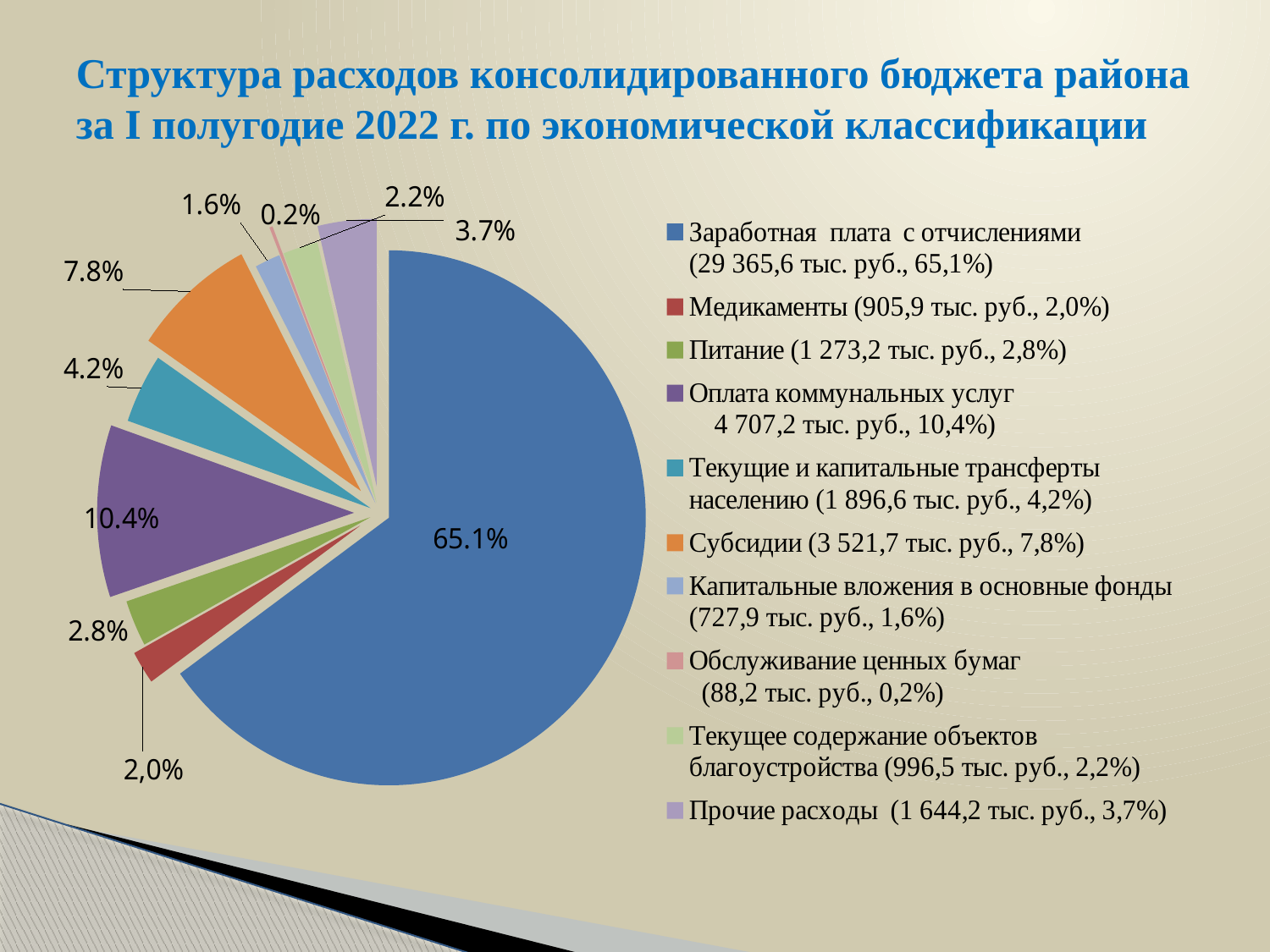
According to the legend, what amount in тыс. руб. is given for Прочие расходы? 1 644,2 тыс. руб. What share of the pie does the slice for Оплата коммунальных услуг represent? 10.4% What share of the pie does the slice for Обслуживание ценных бумаг represent? 0.2% Which category has the largest slice of the pie? Заработная плата с отчислениями How many slices does the pie chart have? 10 What is the difference in percentage points between the share for Оплата коммунальных услуг and the share for Питание? 7.6 What share of the pie does the slice for Заработная плата с отчислениями represent? 65.1% According to the legend, what amount in тыс. руб. is given for Медикаменты? 905,9 тыс. руб. Which category has the smallest slice of the pie? Обслуживание ценных бумаг Which is larger: the share for Субсидии or the share for Текущие и капитальные трансферты населению? Субсидии What kind of chart is shown on the slide? pie chart